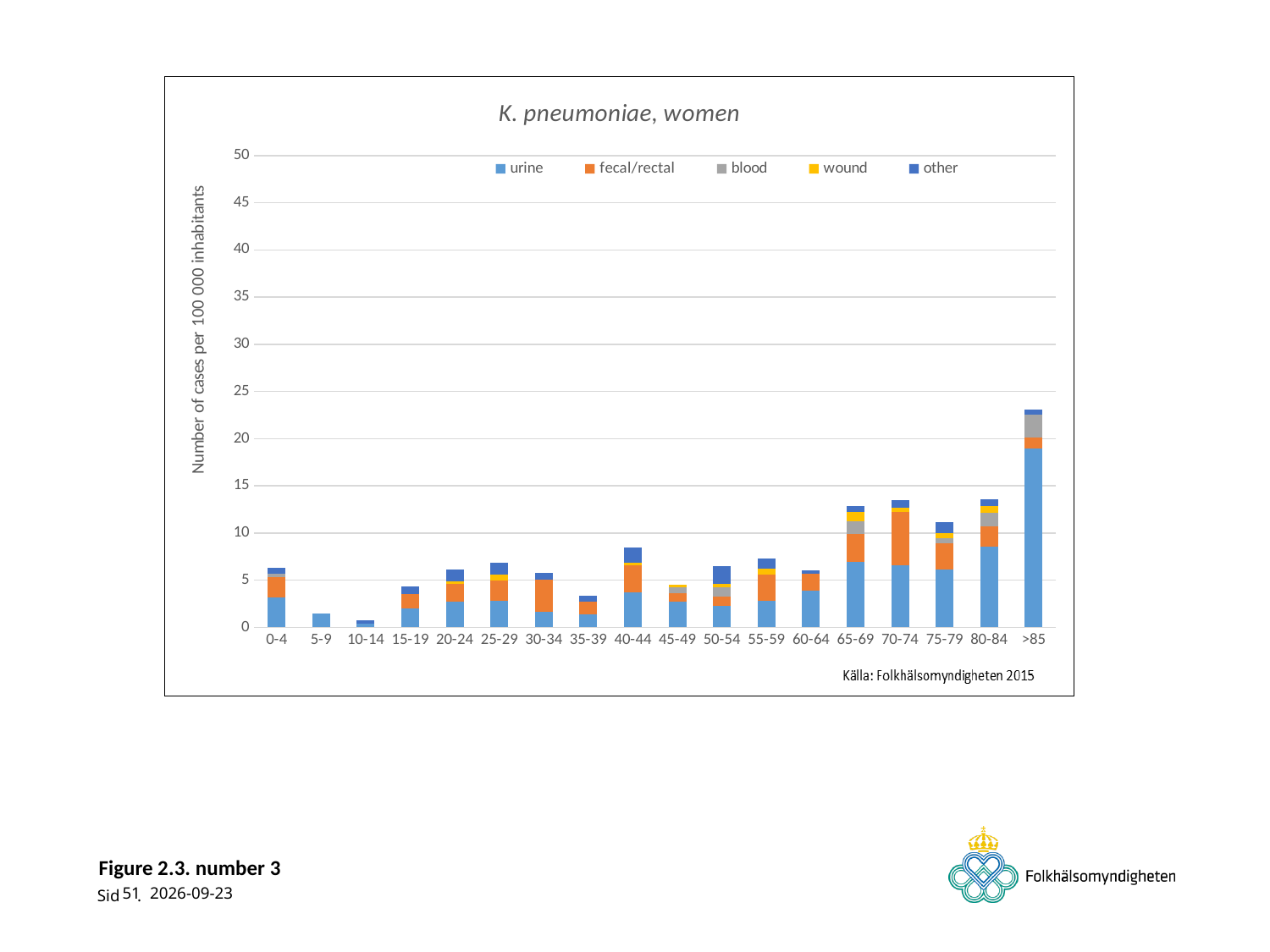
Is the total value for the >85 age group greater or less than 20? greater Is the total value for the 5-9 age group greater or less than 5? less How many age groups are shown on the x axis? 18 What kind of chart is shown on the slide? Stacked bar chart Which age group has the lowest total number of cases? 10-14 Which age group has the highest total number of cases? >85 What is the title of the chart? K. pneumoniae, women How many series does the legend list? 5 Do the total values rise or fall from the 0-4 age group to the 10-14 age group? fall Which age group has a larger total, 40-44 or 35-39? 40-44 Is the total value for the 65-69 age group greater or less than 10? greater Which age group has a larger total, >85 or 80-84? >85